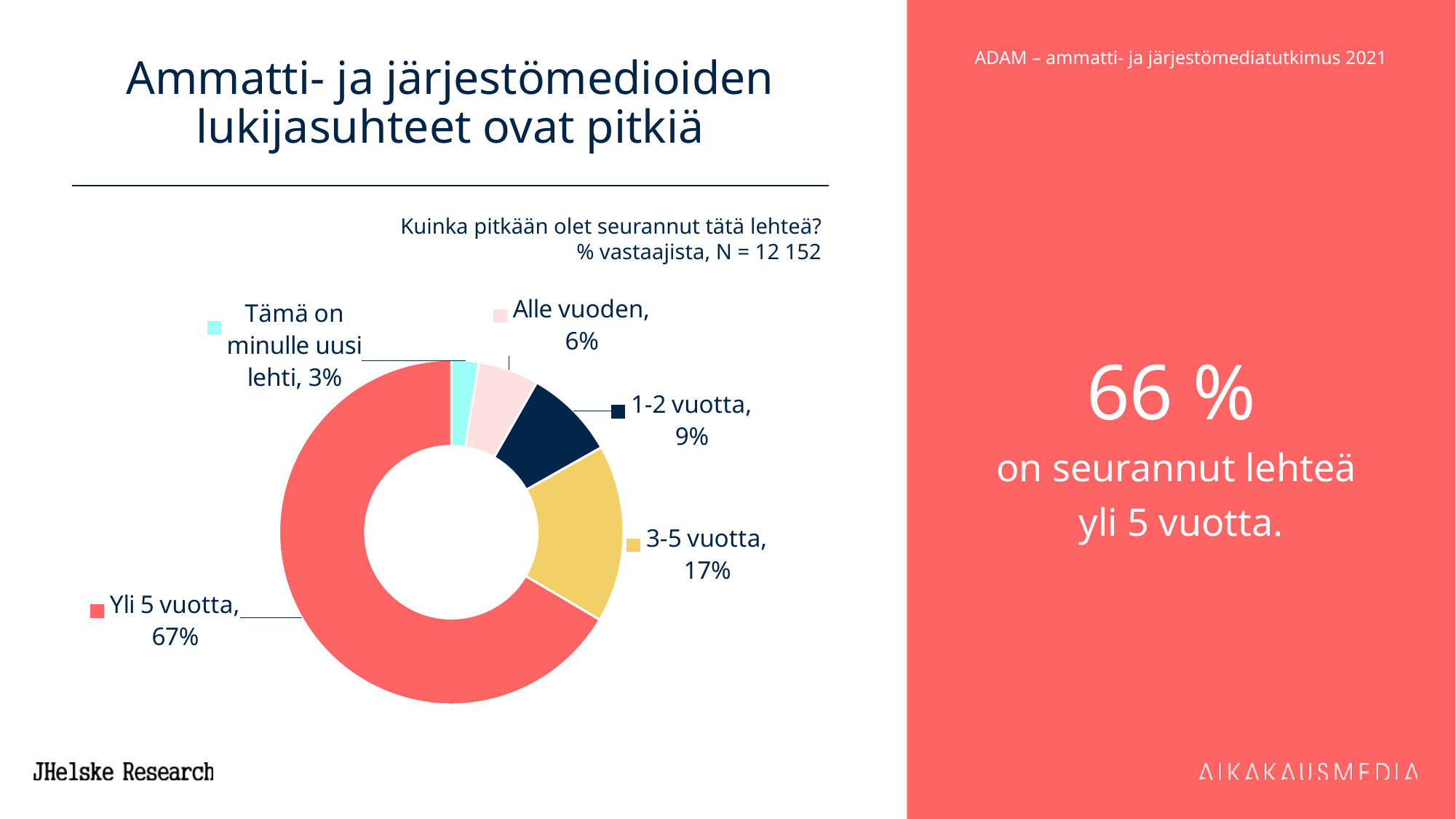
What is the number of respondents (N) stated above the chart? 12 152 How many categories are shown in the chart? 5 What is the value shown for '1-2 vuotta'? 9% What percentage of respondents chose '3-5 vuotta'? 17% What type of chart is shown on the slide? Pie (donut) chart Which is larger: the share for '1-2 vuotta' or the share for 'Alle vuoden'? 1-2 vuotta Which category has the smallest share of the chart? Tämä on minulle uusi lehti What percentage of respondents answered 'Alle vuoden'? 6% What is the difference in percentage points between 'Yli 5 vuotta' and '3-5 vuotta'? 50 What share of respondents have followed the magazine for over 5 years (Yli 5 vuotta)? 67% Which category has the largest share of the chart? Yli 5 vuotta What share of respondents said 'Tämä on minulle uusi lehti'? 3%